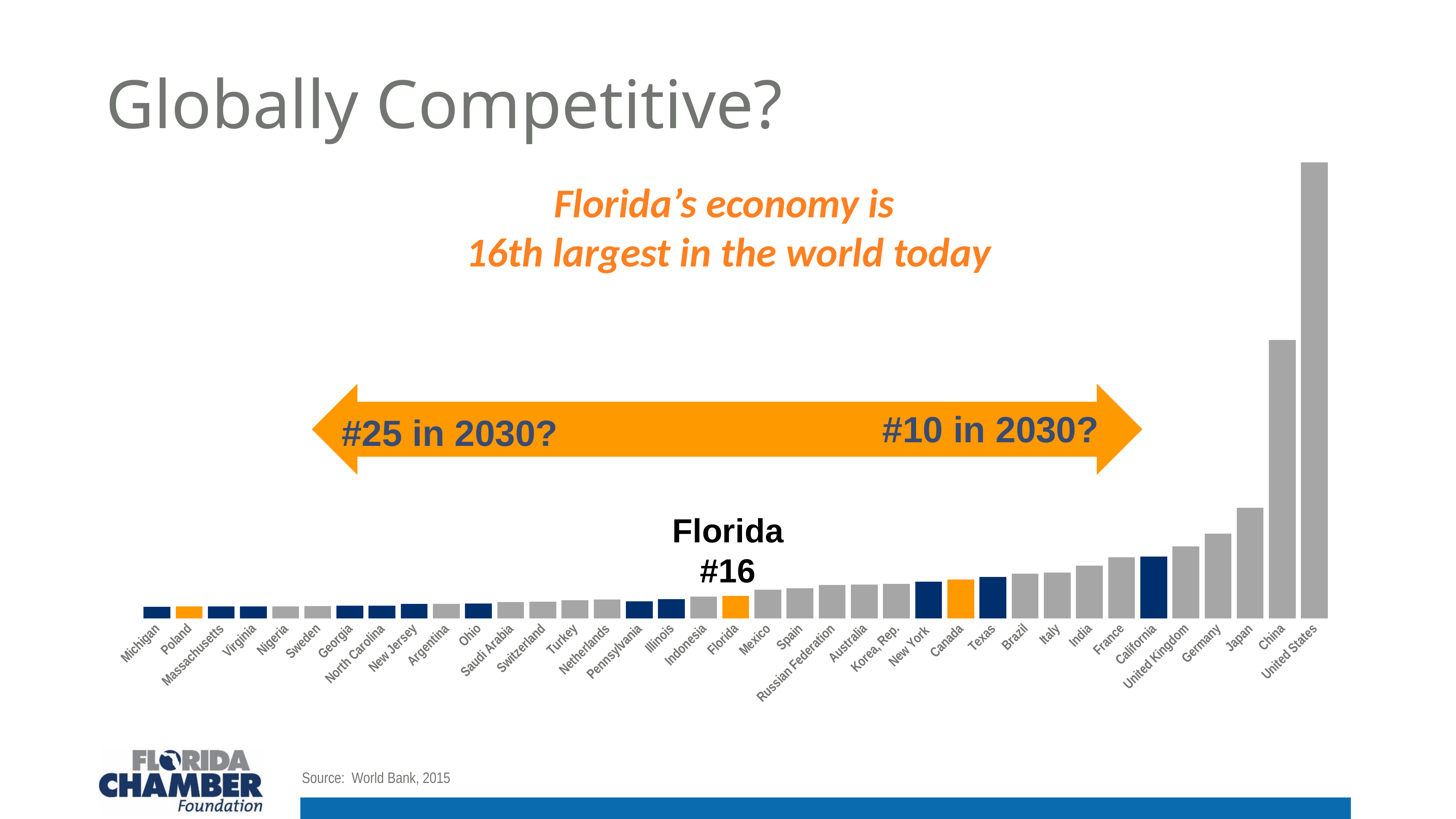
How many categories (bars) are plotted in the chart? 37 Do the bar values rise or fall moving from left to right along the x axis? rise What rank is labelled above the Florida bar in the chart? #16 Which bar is taller, Germany or India? Germany What colour is the Florida bar in the chart? orange Which bar is taller, China or Japan? China What kind of chart is shown on the slide? bar chart Which category has the tallest bar in the chart? United States Which bar is taller, California or United Kingdom? United Kingdom Which category has the shortest bar in the chart? Michigan